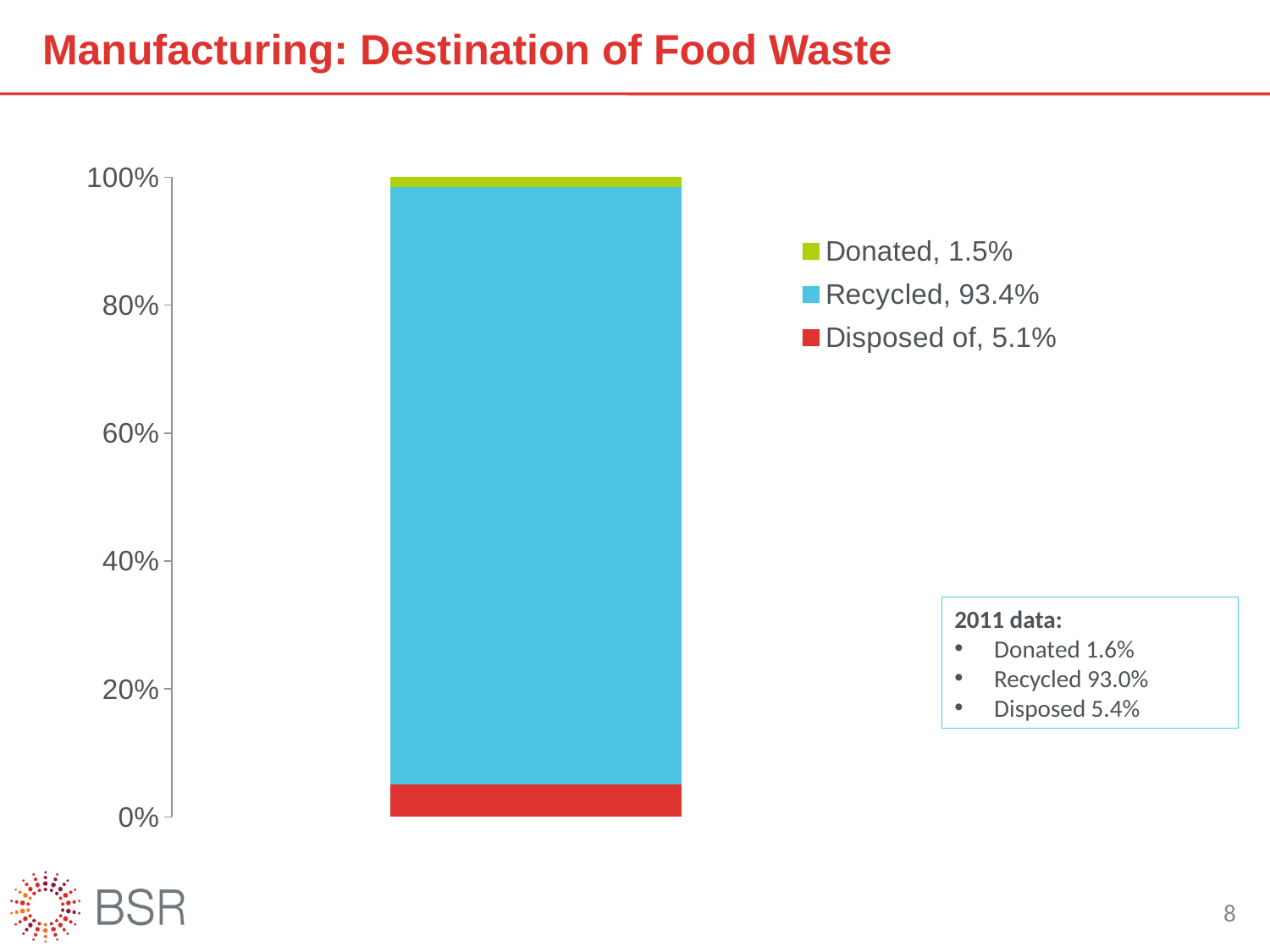
Is the Recycled share greater or less than 80%? greater What is the difference between the Recycled share and the Disposed of share? 88.3% What colour represents Recycled in the chart? Blue What kind of chart is shown on the slide? Stacked bar chart Which destination accounts for the smallest share of food waste? Donated What share of manufacturing food waste is Disposed of? 5.1% Which destination accounts for the largest share of food waste? Recycled What share of manufacturing food waste is Recycled? 93.4% Which is larger, the share Disposed of or the share Donated? Disposed of What is the difference between the Disposed of share and the Donated share? 3.6% What share of manufacturing food waste is Donated? 1.5% How many series does the legend list? 3